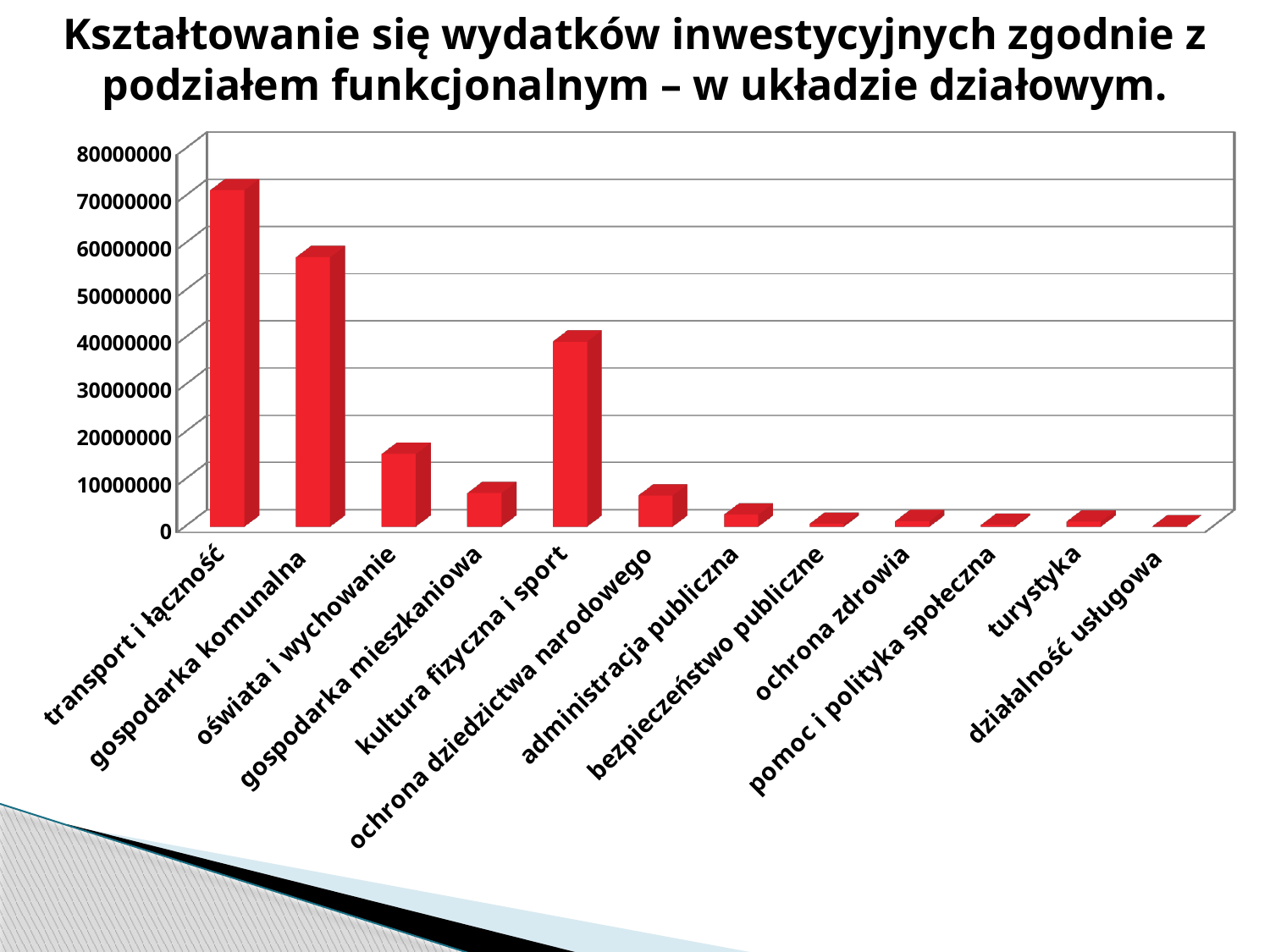
Is the value for gospodarka komunalna greater or less than 50000000? greater Is the value for oświata i wychowanie greater or less than 20000000? less Is the value for transport i łączność greater or less than 60000000? greater Which category has the highest value in the chart? transport i łączność What kind of chart is shown on the slide? bar chart Which is larger, the value for transport i łączność or the value for gospodarka komunalna? transport i łączność Which is larger, the value for kultura fizyczna i sport or the value for oświata i wychowanie? kultura fizyczna i sport Do the bar values generally rise or fall moving from left to right along the x axis? fall What colour are the bars in the chart? red How many categories are shown on the x axis of the chart? 12